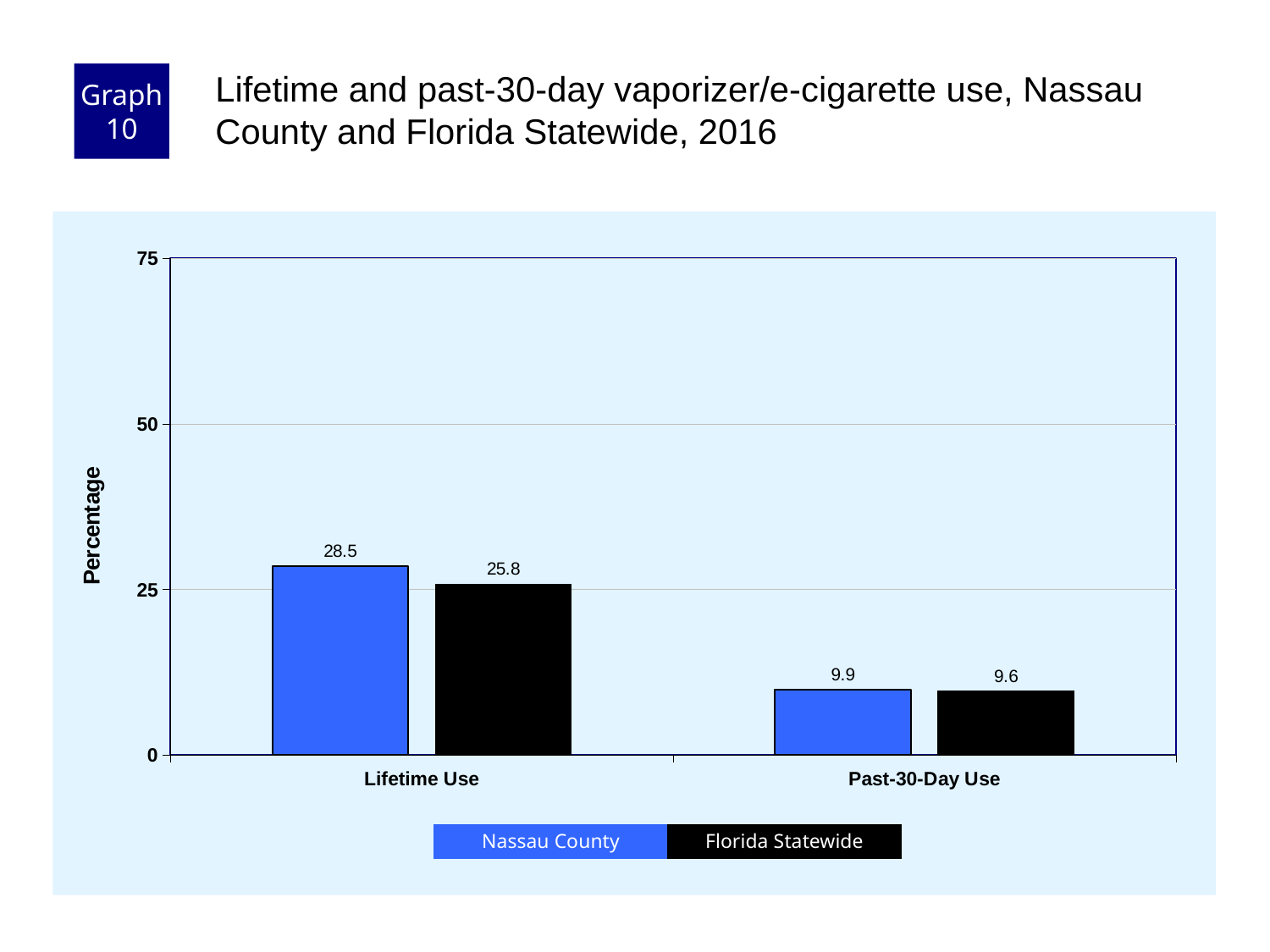
Which category has the highest Nassau County value? Lifetime Use What is the Nassau County value for Lifetime Use? 28.5 What is the difference between the Nassau County and Florida Statewide values for Lifetime Use? 2.7 What is the label on the y axis? Percentage How many series does the legend list? 2 Which category has the lowest Florida Statewide value? Past-30-Day Use What is the Florida Statewide value for Past-30-Day Use? 9.6 What kind of chart is shown on the slide? bar chart What is the Florida Statewide value for Lifetime Use? 25.8 How many categories are shown on the x axis? 2 Is the Nassau County value for Lifetime Use greater or less than 25? greater For Past-30-Day Use, which is larger: Nassau County or Florida Statewide? Nassau County